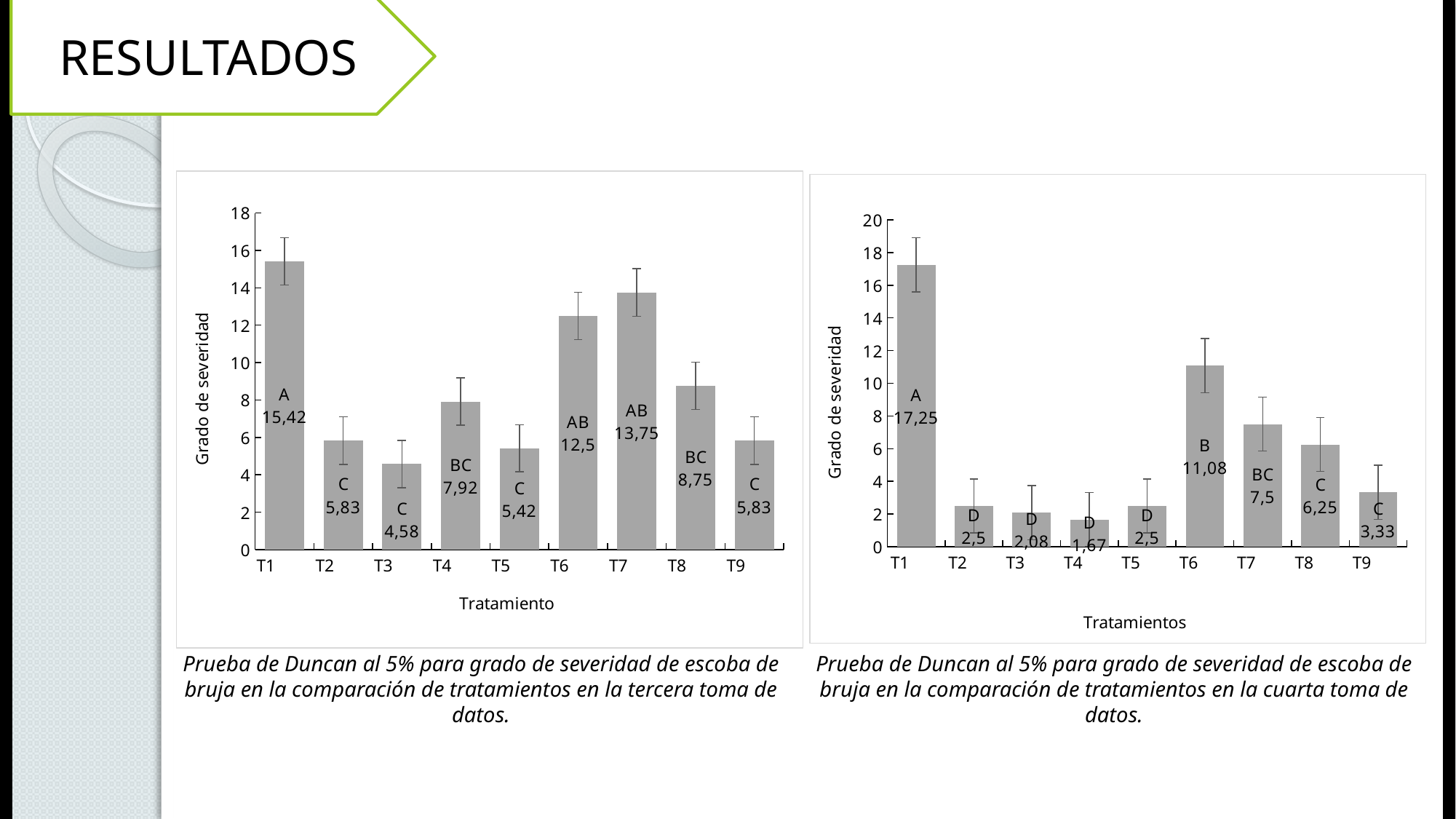
In the left chart (tercera toma de datos), what is the value for T1? 15,42 What is the y-axis label of the left chart (tercera toma de datos)? Grado de severidad What kind of chart is the right chart (cuarta toma de datos)? bar chart In the right chart (cuarta toma de datos), which treatment has the lowest value? T4 In the left chart (tercera toma de datos), which treatment has the lowest value? T3 In the right chart (cuarta toma de datos), is the value for T7 greater or less than 8? less How many treatments are shown on the x axis of the left chart (tercera toma de datos)? 9 In the right chart (cuarta toma de datos), which treatment has the highest value? T1 In the left chart (tercera toma de datos), which is larger, the value for T4 or the value for T8? T8 In the left chart (tercera toma de datos), what is the difference between the values for T7 and T6? 1,25 In the right chart (cuarta toma de datos), what is the difference between the values for T1 and T6? 6,17 In the right chart (cuarta toma de datos), what is the value for T6? 11,08